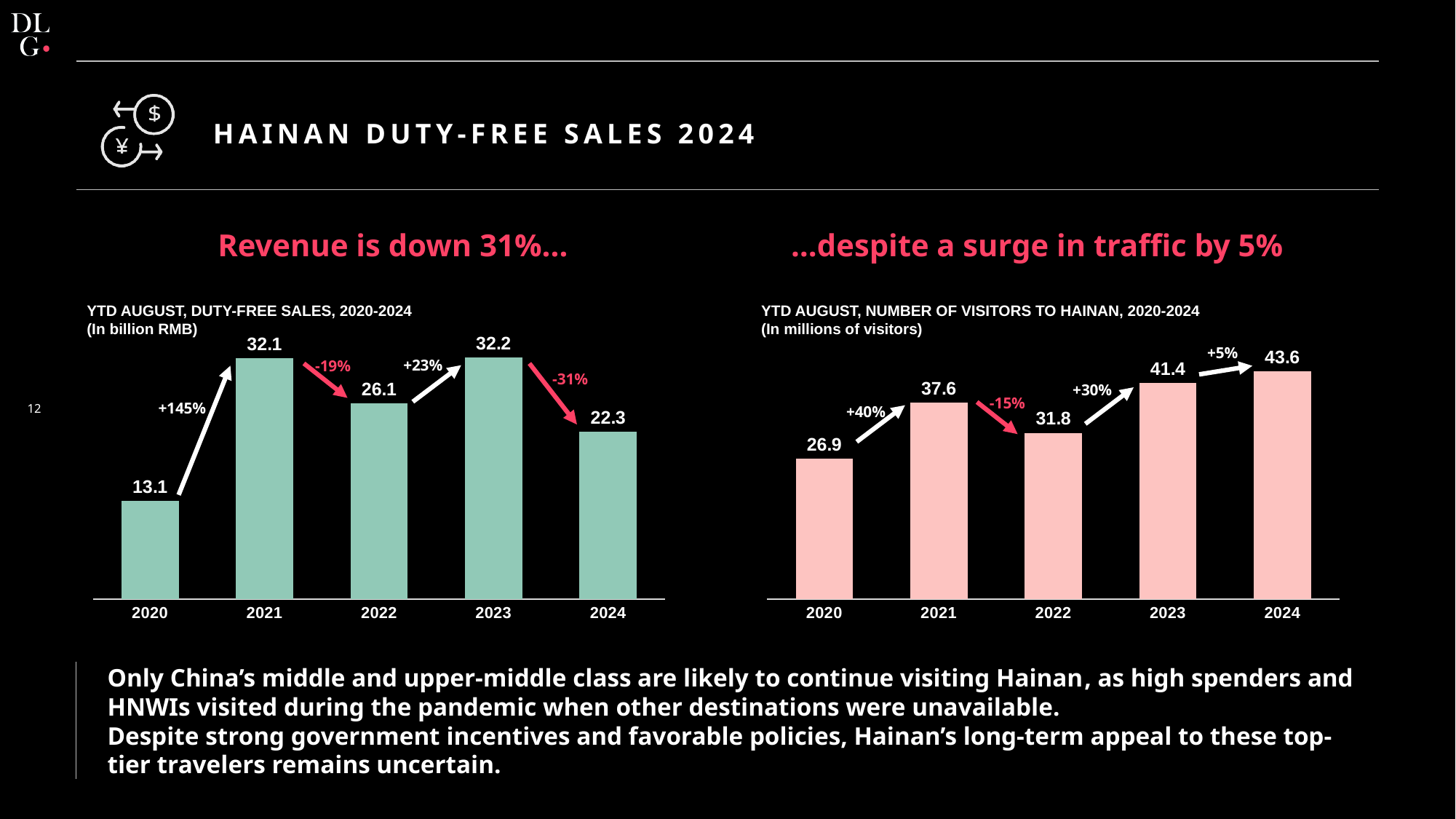
In the number of visitors chart on the right, which year had the highest number of visitors? 2024 In the duty-free sales chart on the left, what was the value for 2020? 13.1 In the duty-free sales chart on the left, which is larger, the value for 2022 or the value for 2024? 2022 In the duty-free sales chart on the left, what was the value for 2024? 22.3 In the number of visitors chart on the right, what is the difference between the 2024 and 2020 values? 16.7 In the duty-free sales chart on the left, which year had the lowest sales? 2020 What type of chart is the duty-free sales chart on the left? Bar chart In the duty-free sales chart on the left, what percentage change is shown between 2023 and 2024? -31% In the number of visitors chart on the right, which year had the lowest number of visitors? 2020 In the duty-free sales chart on the left, what is the difference between the 2023 and 2024 values? 9.9 How many years are shown in the number of visitors chart on the right? 5 In the number of visitors chart on the right, what was the value for 2023? 41.4